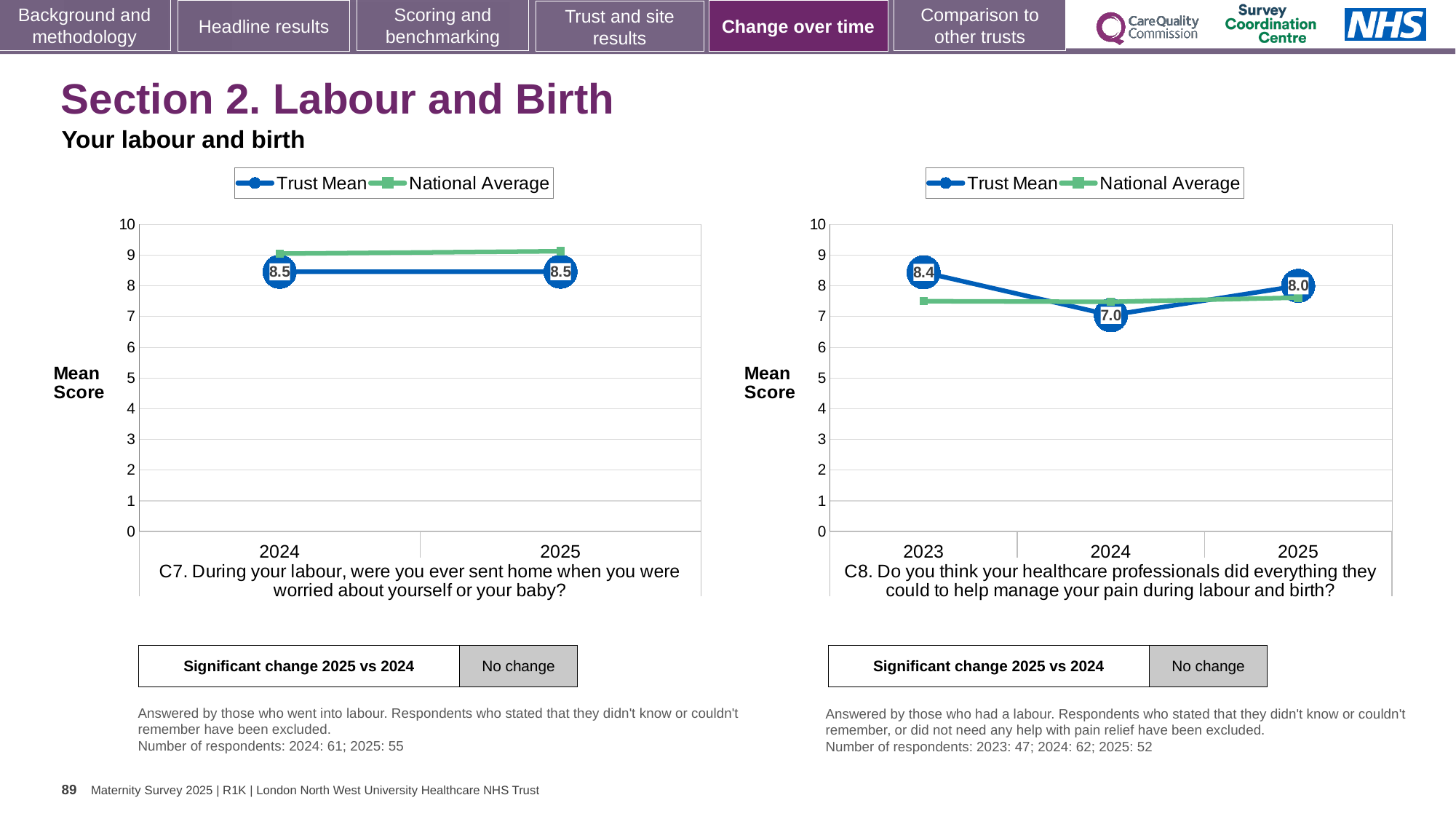
In the C8 chart (right), is the National Average value for 2023 greater or less than 7? greater In the C8 chart (right), which year has the lowest Trust Mean score? 2024 In the C8 chart (right), what is the Trust Mean score for 2024? 7.0 How many series does the legend of the C7 chart (left) list? 2 In the C8 chart (right), what is the Trust Mean score for 2025? 8.0 What type of chart is the C7 chart (left)? Line chart In the C8 chart (right), what is the difference between the Trust Mean scores for 2023 and 2024? 1.4 In the C7 chart (left), what is the Trust Mean score for 2025? 8.5 How many years are plotted on the x axis of the C8 chart (right)? 3 In the C8 chart (right), is the Trust Mean score for 2025 larger or smaller than the score for 2024? larger In the C7 chart (left), what is the Trust Mean score for 2024? 8.5 In the C8 chart (right), which year has the highest Trust Mean score? 2023